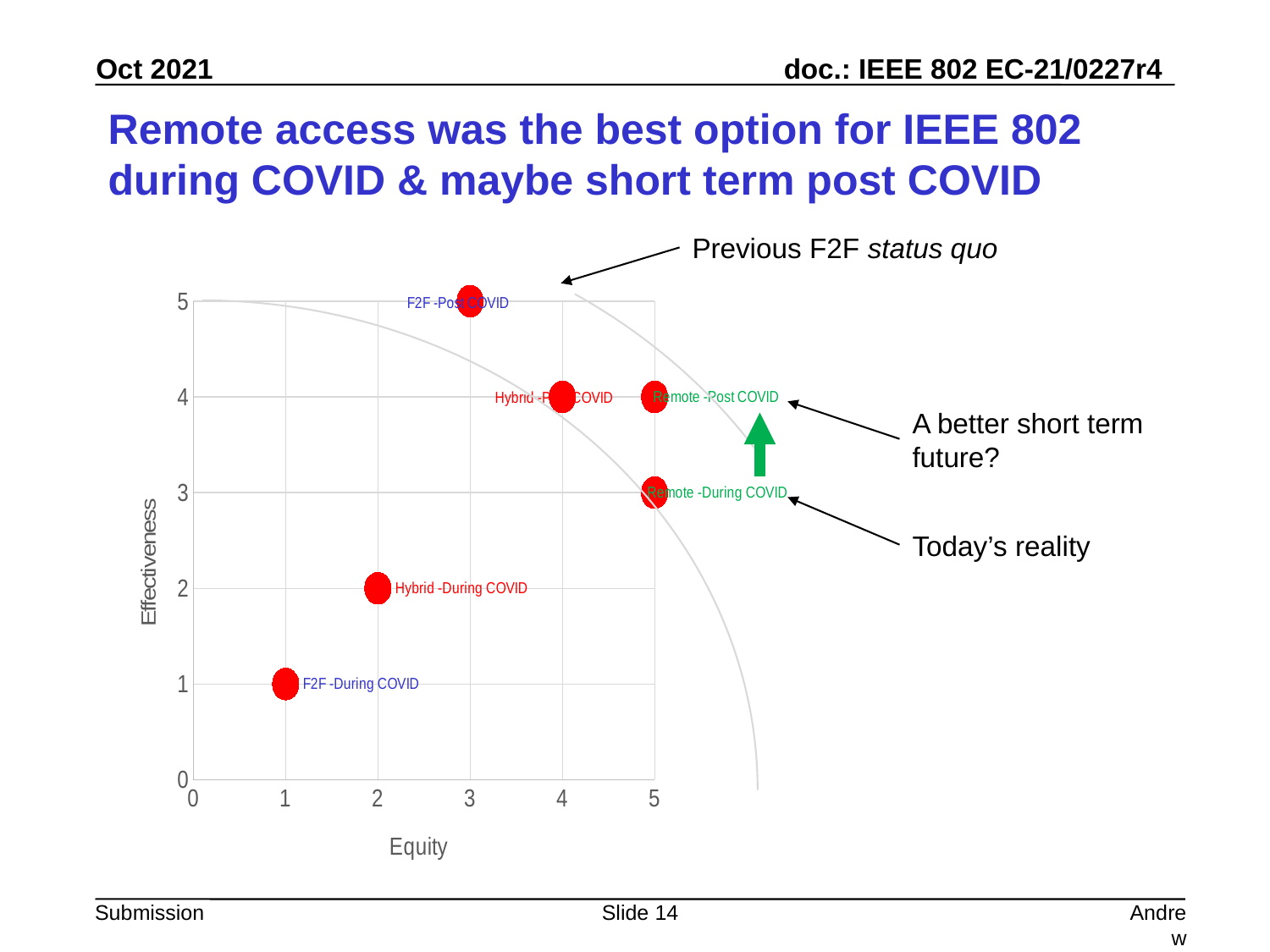
What is the Equity value for Hybrid - During COVID? 2 What is the label of the y axis? Effectiveness What is the Effectiveness value for F2F - Post COVID? 5 Which point has the lowest Equity value? F2F - During COVID What kind of chart is shown on the slide? Scatter chart What is the label of the x axis? Equity How many data points are plotted on the chart? 6 Which point has the highest Effectiveness value? F2F - Post COVID What is the difference in Effectiveness between Remote - Post COVID and Remote - During COVID? 1 Which has a higher Equity value, Remote - Post COVID or Hybrid - Post COVID? Remote - Post COVID What is the Equity value for F2F - During COVID? 1 What is the Effectiveness value for Remote - During COVID? 3